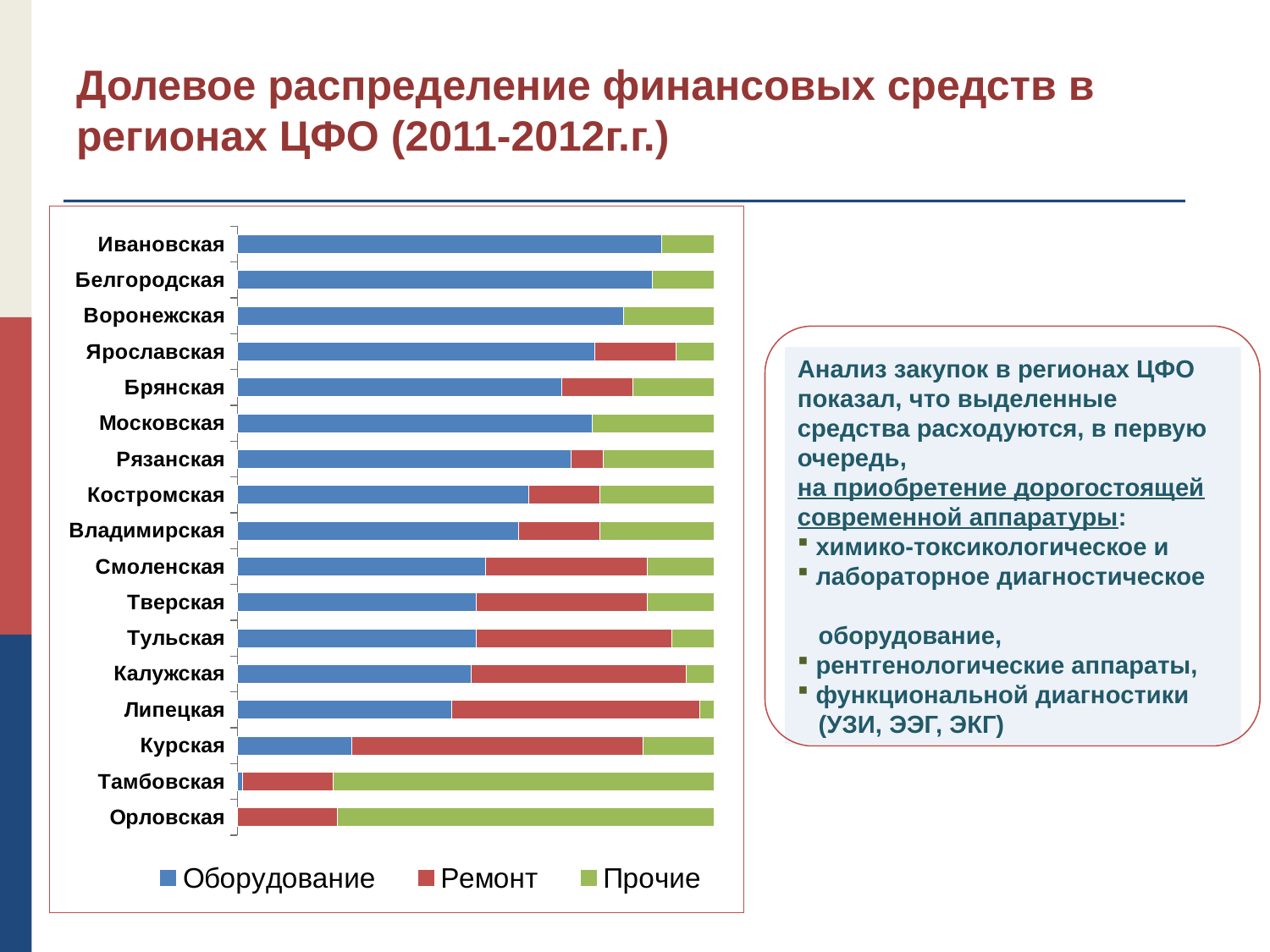
How many regions are shown on the chart? 17 Which region has the largest Ремонт share? Курская Which region has the largest Оборудование share? Ивановская What are the three series listed in the chart legend? Оборудование, Ремонт, Прочие Which region has the smallest Оборудование share? Орловская What colour represents the Ремонт series in the chart? Red How many series does the chart legend list? 3 What type of chart is shown on the slide? Stacked bar chart Which region has the larger Прочие share, Тамбовская or Липецкая? Тамбовская Which region has the larger Оборудование share, Белгородская or Тверская? Белгородская Which region has the larger Ремонт share, Смоленская or Рязанская? Смоленская